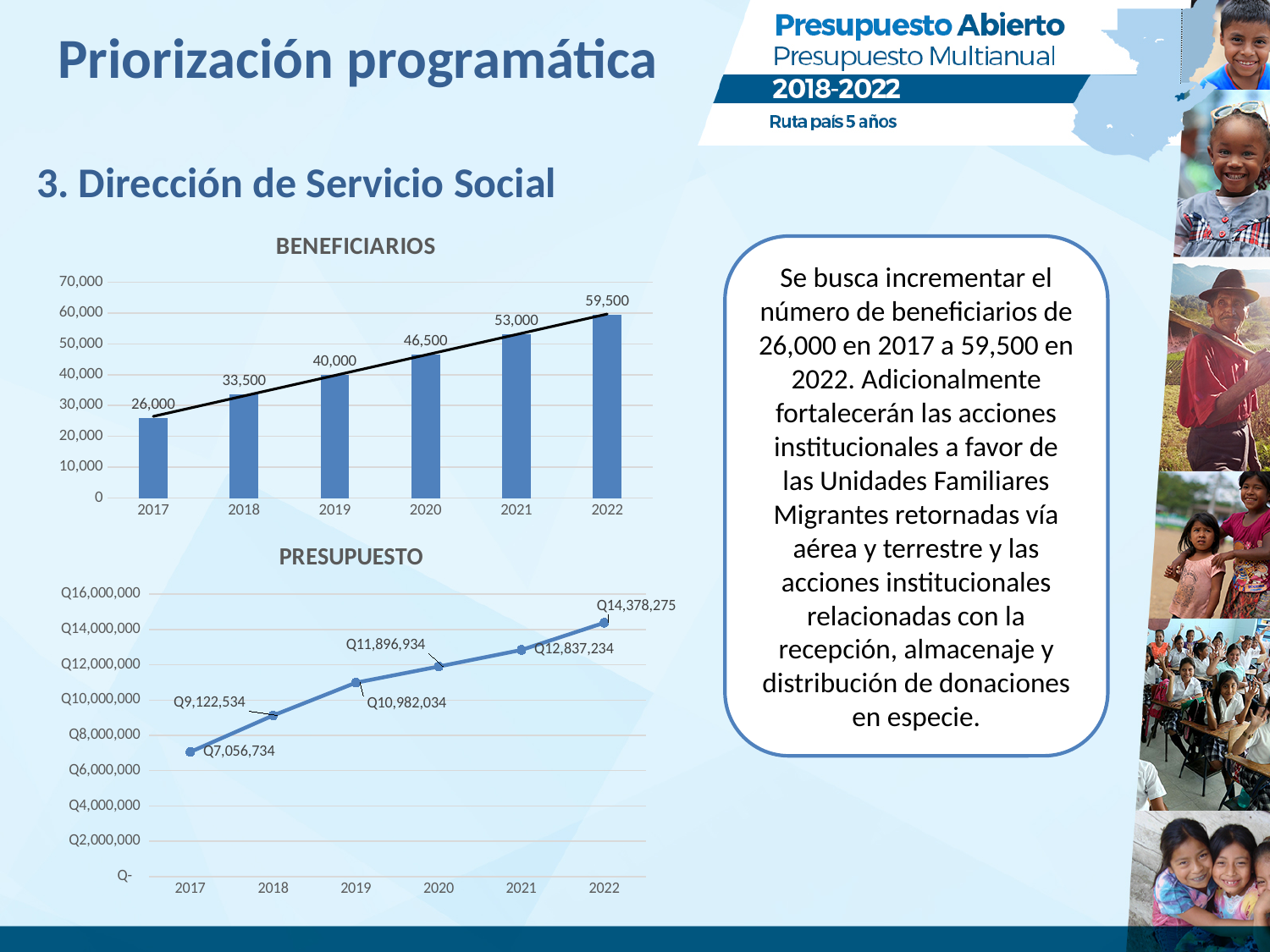
In the PRESUPUESTO chart, which is larger, the value for 2018 or the value for 2020? 2020 In the PRESUPUESTO chart, what is the value for 2022? Q14,378,275 What kind of chart is the BENEFICIARIOS chart? Bar chart In the BENEFICIARIOS chart, do the values rise or fall from 2017 to 2022? Rise In the BENEFICIARIOS chart, what is the value for 2020? 46,500 What kind of chart is the PRESUPUESTO chart? Line chart In the PRESUPUESTO chart, what is the value for 2019? Q10,982,034 In the BENEFICIARIOS chart, which year has the highest value? 2022 In the BENEFICIARIOS chart, what is the difference between the values for 2022 and 2017? 33,500 In the BENEFICIARIOS chart, how many years are shown on the x axis? 6 In the PRESUPUESTO chart, which year has the lowest value? 2017 In the BENEFICIARIOS chart, what is the value for 2017? 26,000